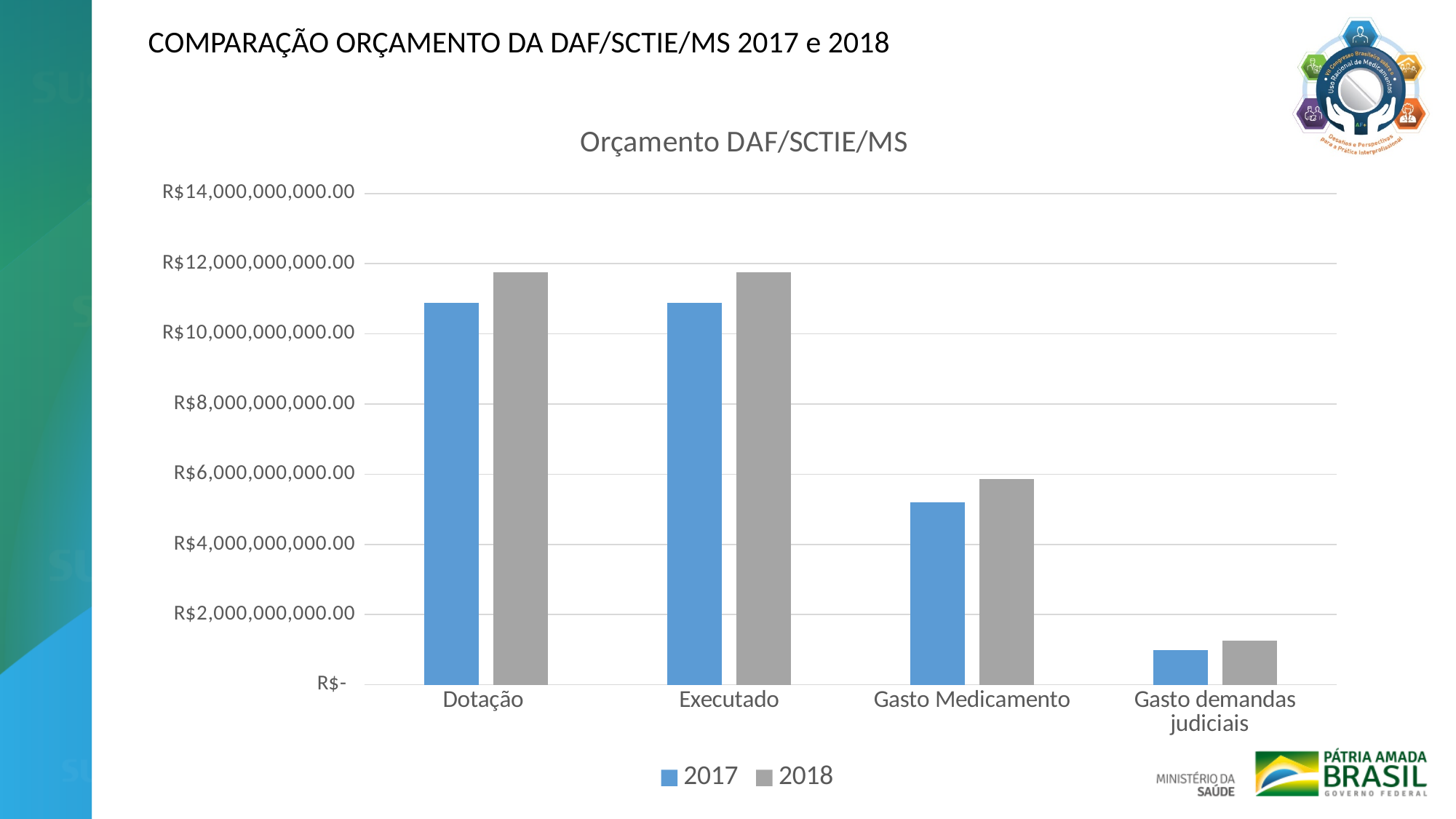
Is the 2018 value for Executado greater or less than R$12,000,000,000.00? less Do the 2018 values rise or fall from Executado to Gasto demandas judiciais along the x axis? fall Is the 2017 value for Gasto demandas judiciais greater or less than R$2,000,000,000.00? less Is the 2017 value for Gasto Medicamento greater or less than R$4,000,000,000.00? greater Which category has the lowest value for 2017? Gasto demandas judiciais What is the title of the chart? Orçamento DAF/SCTIE/MS How many series does the legend list? 2 For Gasto Medicamento, which year has the larger value, 2017 or 2018? 2018 Which category has the lowest value for 2018? Gasto demandas judiciais How many categories are shown on the x axis? 4 What kind of chart is shown on the slide? Bar chart